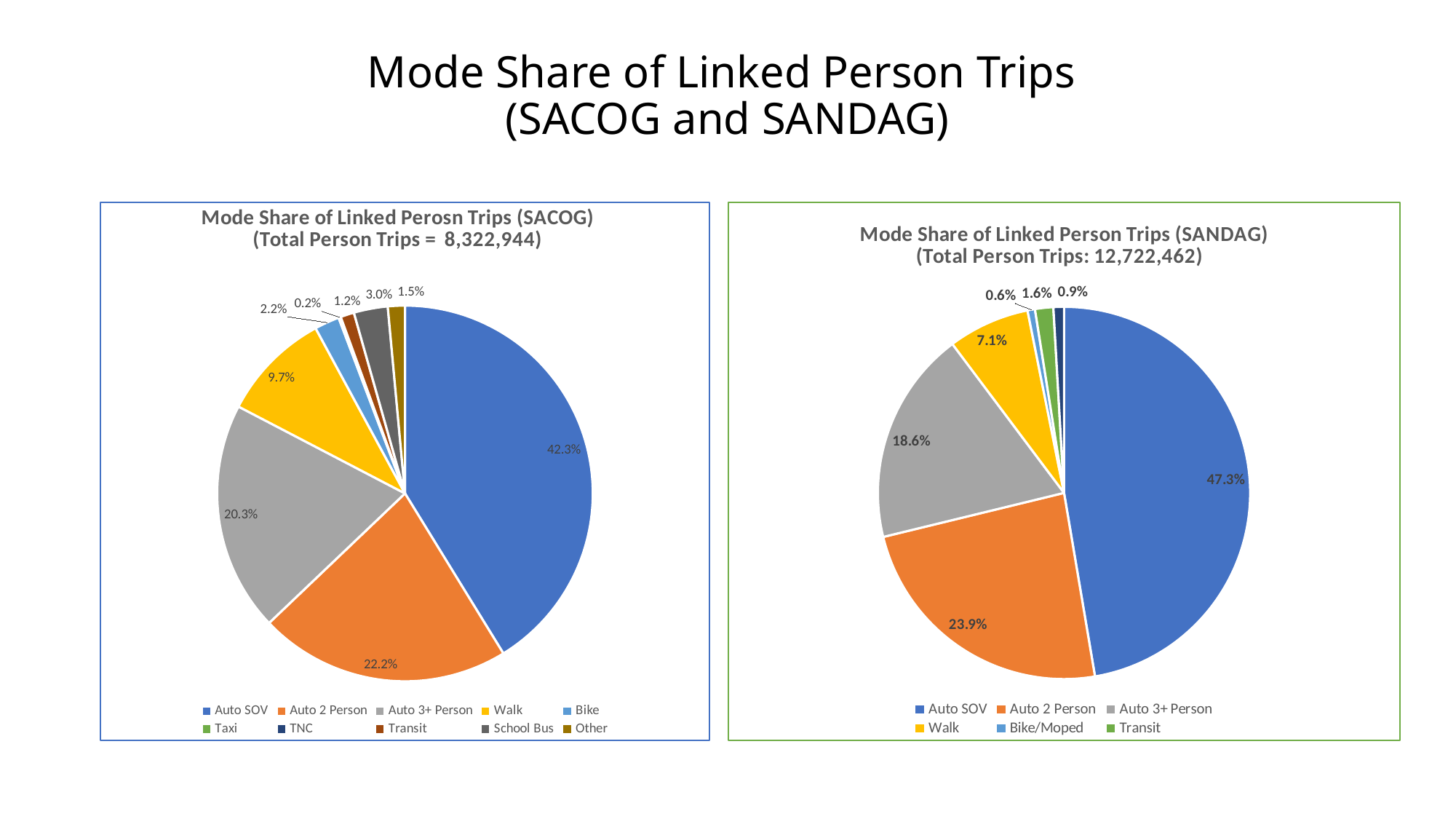
How many series does the legend of the SANDAG pie chart list? 6 What total number of person trips is stated in the SANDAG chart title? 12,722,462 In the SANDAG pie chart, what share is Walk? 7.1% In the SACOG pie chart, which mode has the largest share? Auto SOV In the SACOG pie chart, what share of linked person trips is Auto SOV? 42.3% In the SANDAG pie chart, what share of linked person trips is Auto 2 Person? 23.9% What type of chart is used on the left for SACOG? Pie chart In the SANDAG pie chart, which legend mode has the smallest share? Bike/Moped What is the difference between the Auto SOV shares in the SANDAG and SACOG pie charts? 5.0% In the SACOG pie chart, what share is Auto 3+ Person? 20.3% In the SACOG pie chart, which is larger: Walk or Auto 3+ Person? Auto 3+ Person How many series does the legend of the SACOG pie chart list? 10